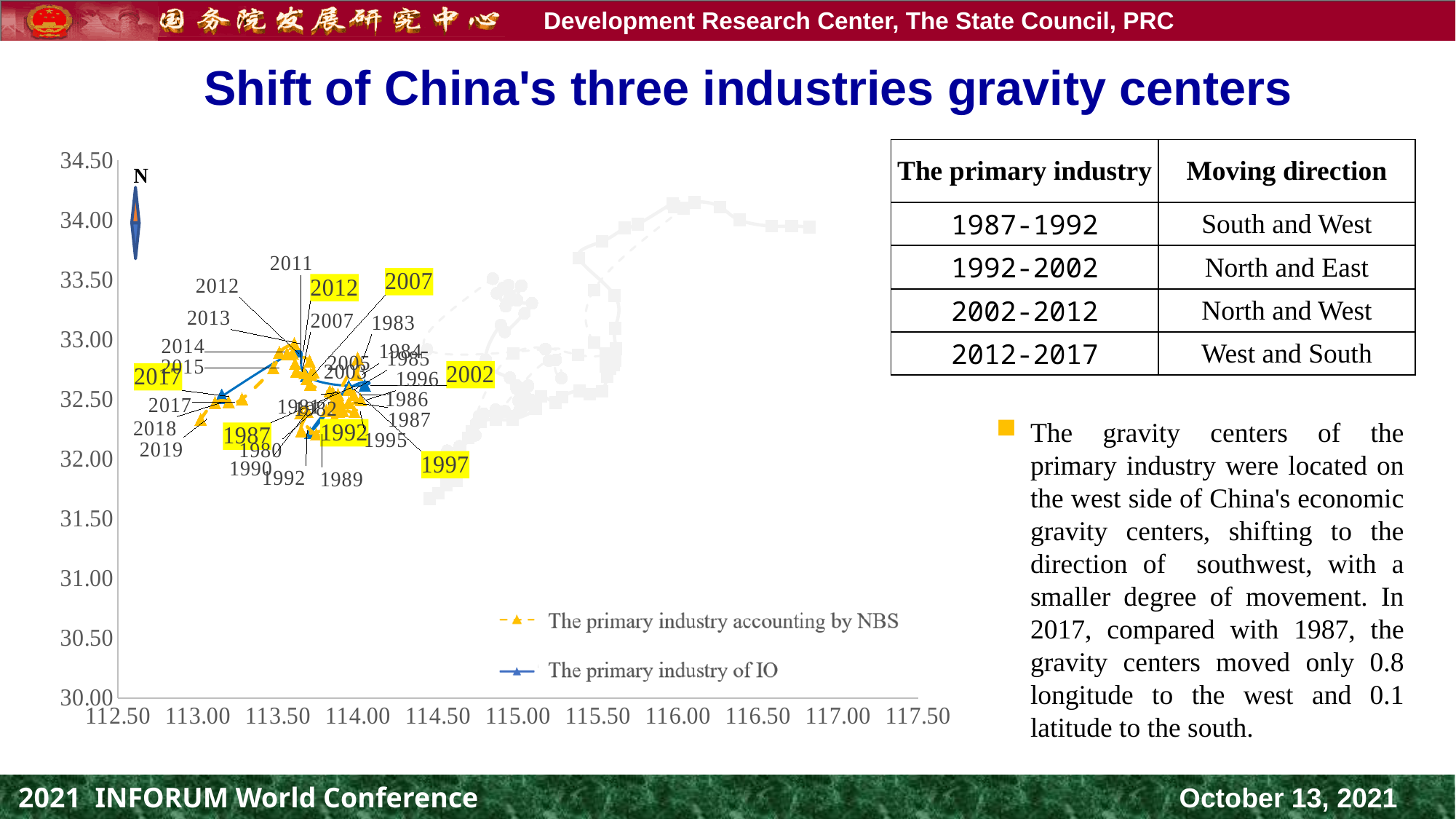
What is the highest value shown on the y axis of the chart? 34.50 Is the longitude (x value) of the highlighted 2002 point greater or less than 113.50? greater Is the latitude (y value) of the highlighted 1992 point greater or less than 32.50? less Which colour is used for the series 'The primary industry of IO'? Blue Is the latitude (y value) of the highlighted 2007 point greater or less than 32.50? greater What are the two series named in the chart legend? The primary industry accounting by NBS; The primary industry of IO Between 2012 and 2017, does the primary industry of IO series move east or west along the x axis? west How many series does the chart legend list? 2 What kind of chart is shown on the slide? Scatter (line) chart